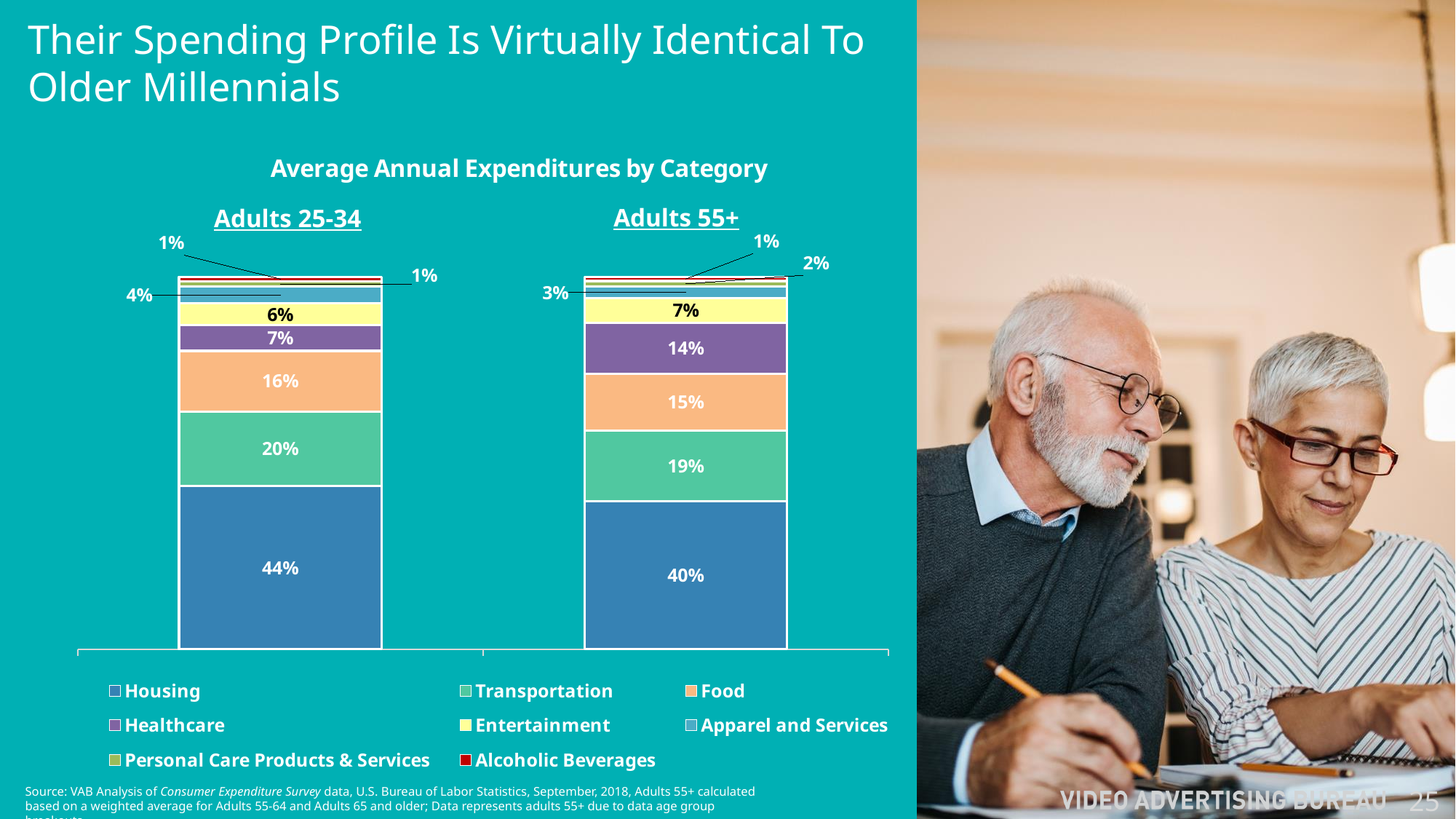
What is the Healthcare share for Adults 55+? 14% What share of spending goes to Housing for Adults 25-34? 44% By how many percentage points does the Healthcare share for Adults 55+ exceed that for Adults 25-34? 7 percentage points Which group has the larger Food share, Adults 25-34 or Adults 55+? Adults 25-34 What kind of chart is shown on the slide? Stacked bar chart How many series does the chart legend list? 8 What is the title of the chart? Average Annual Expenditures by Category What is the Entertainment share for Adults 55+? 7% How many bars (age groups) are shown in the chart? 2 What is the Transportation share for Adults 25-34? 20% Which category has the largest share for Adults 55+? Housing What share of spending goes to Housing for Adults 55+? 40%